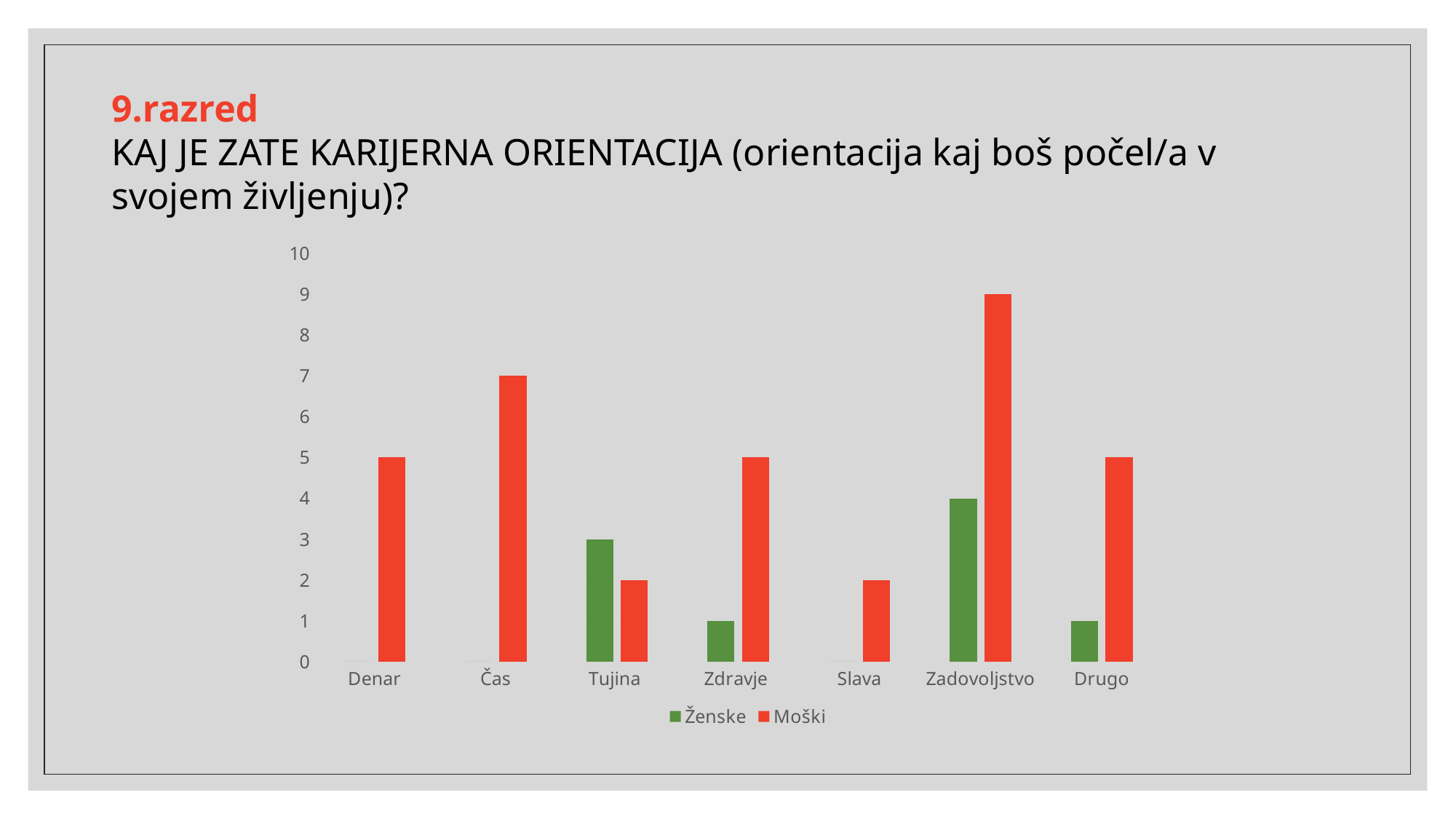
In the Tujina category, which series has the larger value, Ženske or Moški? Ženske How many series does the chart legend list? 2 Which category has the highest value for Moški? Zadovoljstvo Which category has the highest value for Ženske? Zadovoljstvo What is the value for Moški in the Čas category? 7 Is the value for Moški in the Čas category greater or less than 5? greater Which series is shown in green in the chart legend? Ženske What kind of chart is shown on the slide? bar chart How many categories are shown on the x axis of the chart? 7 What is the difference between the Moški and Ženske values in the Zadovoljstvo category? 5 What is the value for Moški in the Zadovoljstvo category? 9 What is the value for Ženske in the Tujina category? 3